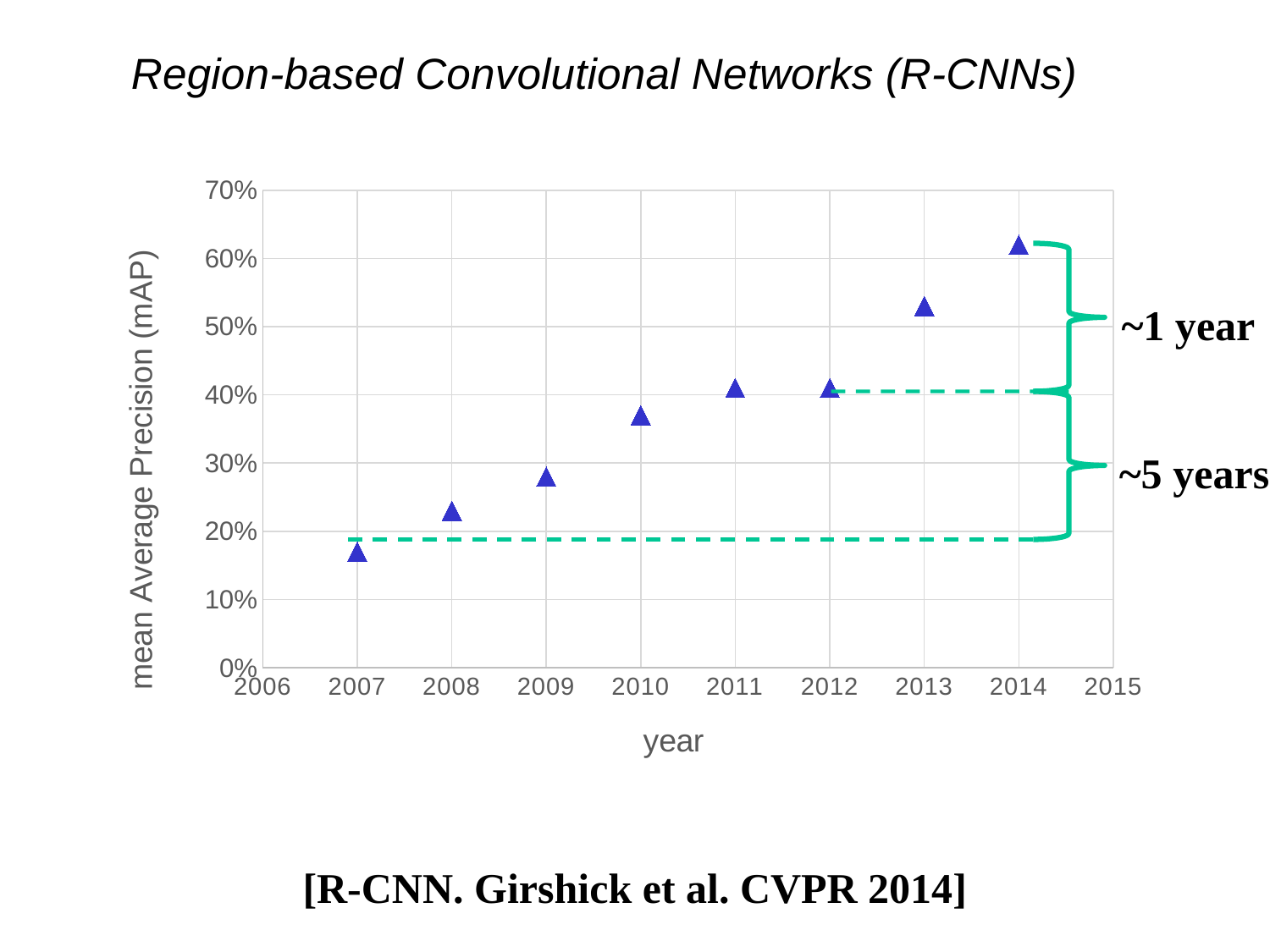
Is the mAP value for 2014 greater or less than 60%? greater Is the mAP value for 2010 greater or less than 40%? less How many data points are plotted on the chart? 8 Is the mAP value for 2007 greater or less than 20%? less Which year has the highest mean Average Precision? 2014 What is the label of the y axis? mean Average Precision (mAP) What kind of chart is shown on the slide? scatter plot Do the mAP values generally rise or fall from 2007 to 2014? rise Which year has the lowest mean Average Precision? 2007 Which year has a higher mAP, 2009 or 2013? 2013 What is the label of the x axis? year